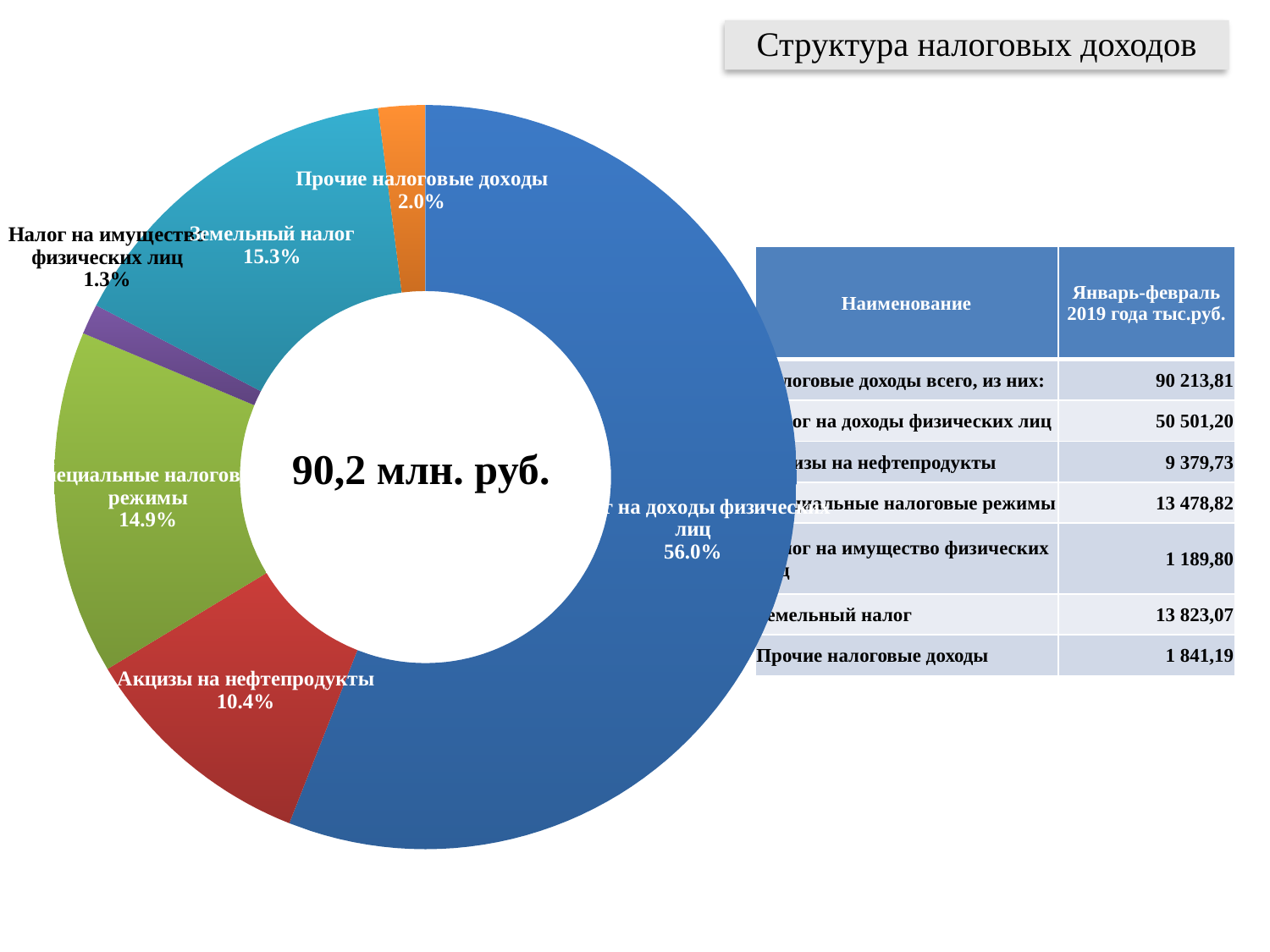
What kind of chart is shown on the slide? Doughnut (pie) chart Which has the larger share: "Земельный налог" or "Специальные налоговые режимы"? Земельный налог What percentage is shown for "Акцизы на нефтепродукты" in the chart? 10.4% What percentage is shown for "Прочие налоговые доходы" in the chart? 2.0% What total amount is printed in the centre of the chart? 90,2 млн. руб. How many categories (slices) does the chart show? 6 Which category has the largest share in the chart? Налог на доходы физических лиц What share of tax revenues does "Налог на доходы физических лиц" account for in the chart? 56.0% Which category has the smallest share in the chart? Налог на имущество физических лиц What is the difference in percentage points between "Земельный налог" and "Акцизы на нефтепродукты"? 4.9 percentage points What percentage is shown for "Специальные налоговые режимы" in the chart? 14.9% What percentage is shown for "Земельный налог" in the chart? 15.3%